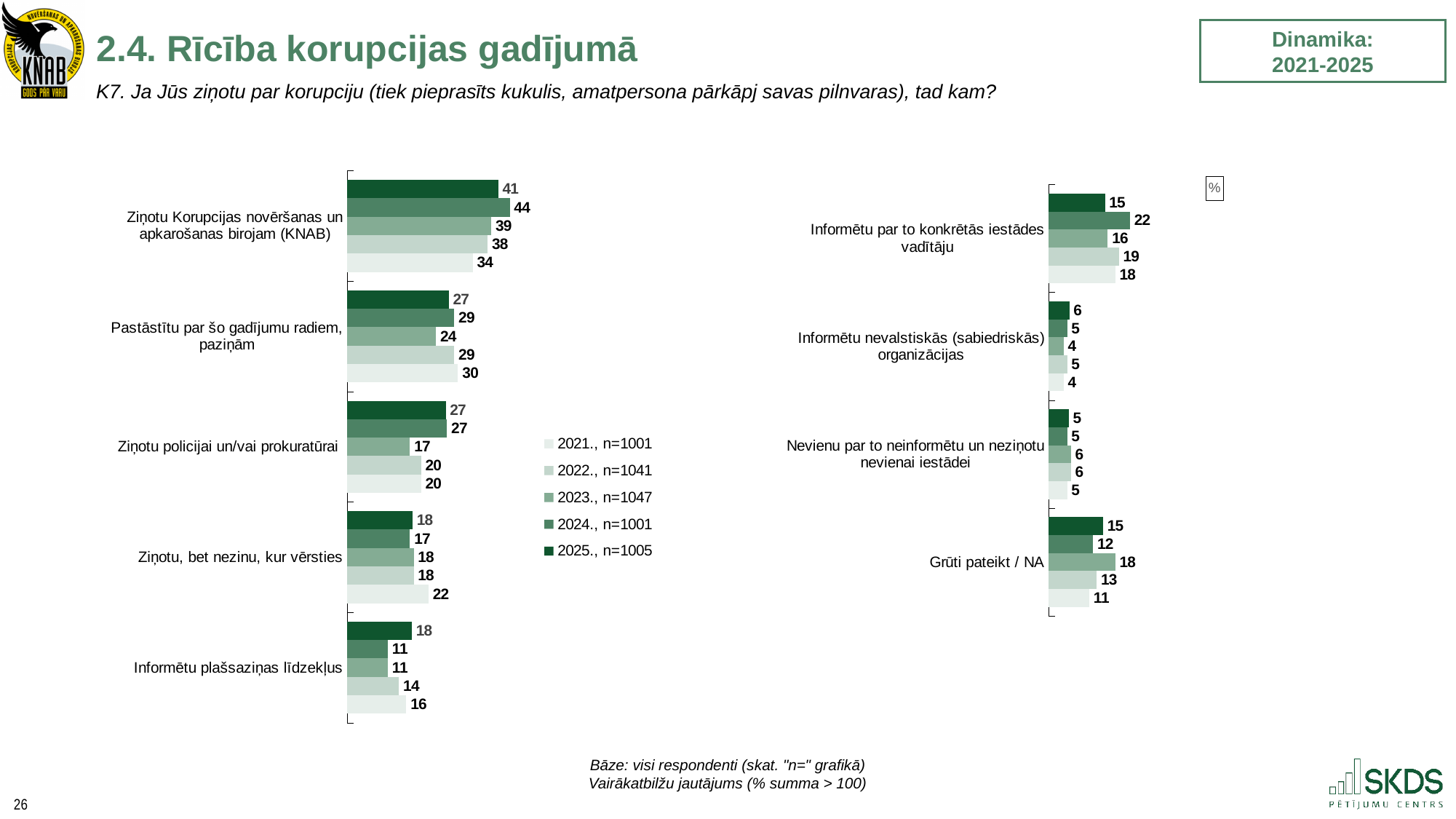
In the left chart, which category has the highest 2025 value? Ziņotu Korupcijas novēršanas un apkarošanas birojam (KNAB) In the right chart, what is the 2024 value for 'Informētu par to konkrētās iestādes vadītāju'? 22 How many categories does the left chart show? 5 How many series does the legend list? 5 In the left chart, what is the difference between the 2024 and 2021 values for 'Ziņotu Korupcijas novēršanas un apkarošanas birojam (KNAB)'? 10 In the left chart, what is the 2025 value for 'Ziņotu Korupcijas novēršanas un apkarošanas birojam (KNAB)'? 41 What kind of chart is used on this slide? Bar chart In the right chart, what is the difference between the 2025 and 2021 values for 'Grūti pateikt / NA'? 4 In the left chart, which is larger for 'Ziņotu policijai un/vai prokuratūrai': the 2025 value or the 2023 value? 2025 In the right chart, what is the 2023 value for 'Grūti pateikt / NA'? 18 In the right chart, which category has the lowest 2021 value? Informētu nevalstiskās (sabiedriskās) organizācijas In the left chart, what is the 2021 value for 'Informētu plašsaziņas līdzekļus'? 16